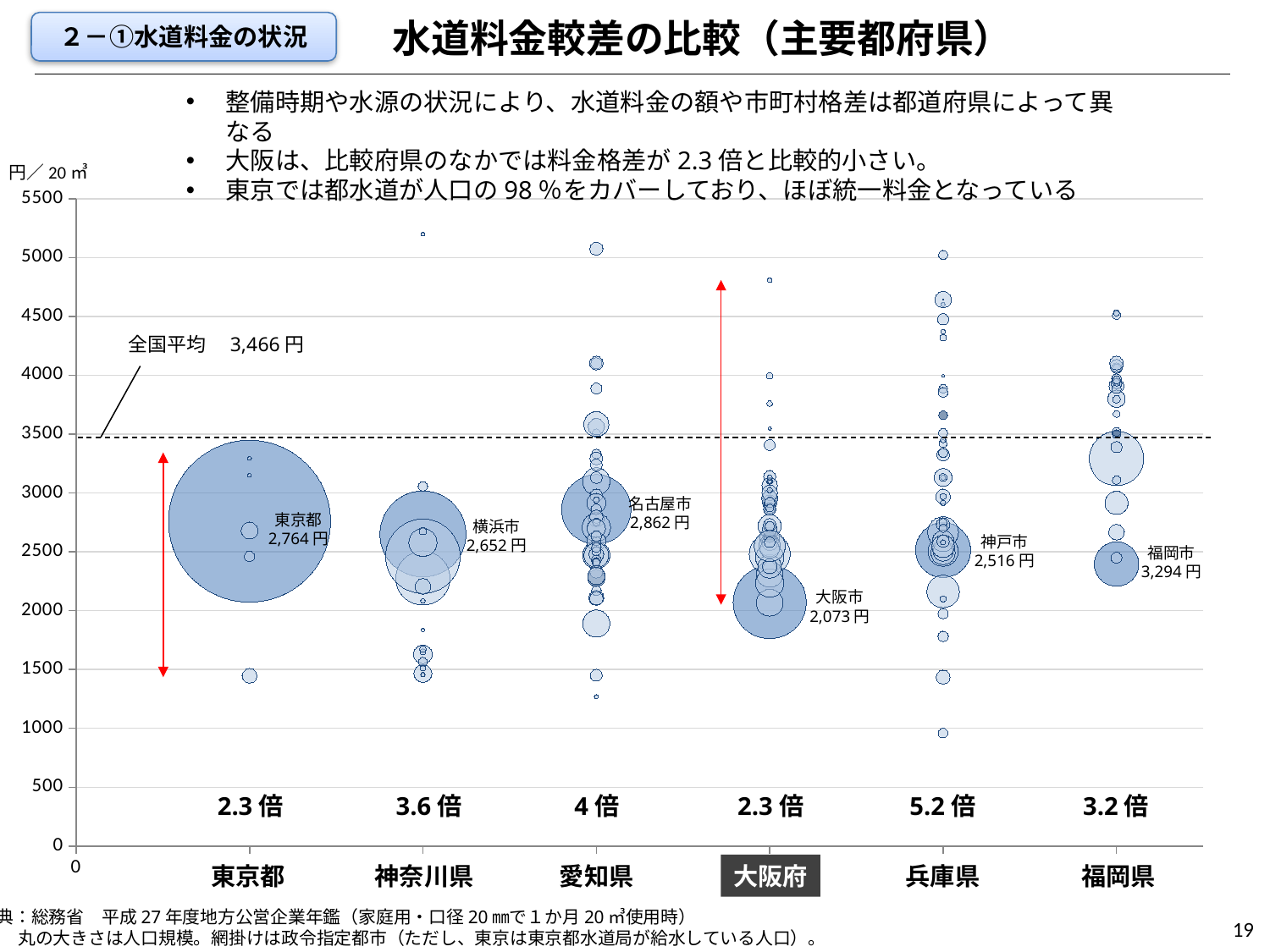
What is the water rate labeled for 大阪市 on the chart? 2,073円 How many prefectures are shown along the x axis of the chart? 6 Which prefecture label on the x axis is highlighted with a dark background? 大阪府 Among the labeled cities (東京都, 横浜市, 名古屋市, 大阪市, 神戸市, 福岡市), which has the lowest water rate? 大阪市 Which has a higher labeled water rate, 名古屋市 or 横浜市? 名古屋市 What is the rate disparity ratio shown for 兵庫県? 5.2倍 What is the water rate shown for 東京都 (Tokyo) on the chart? 2,764円 What is the difference between the labeled rates of 福岡市 and 大阪市? 1,221円 What kind of chart is shown on the slide? bubble chart What is the national average (全国平均) water rate shown by the dashed line? 3,466円 Which prefecture has the highest rate disparity ratio shown on the chart? 兵庫県